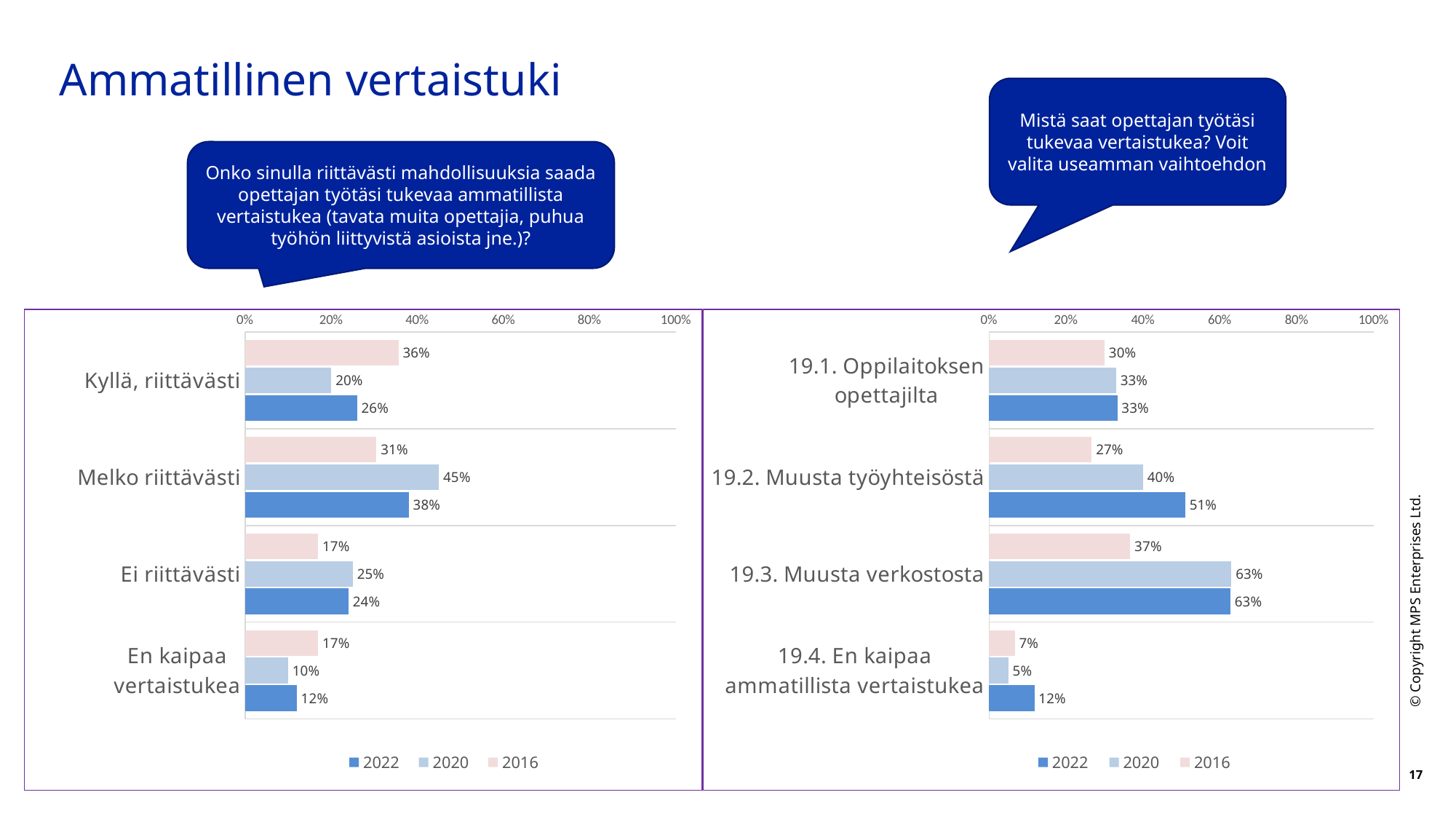
In the right chart, what is the 2016 value for "19.4. En kaipaa ammatillista vertaistukea"? 7% In the right chart, which category has the highest 2022 value? 19.3. Muusta verkostosta In the left chart, what is the difference between the 2020 and 2016 values for "Kyllä, riittävästi"? 16% In the left chart, what is the 2022 value for "Melko riittävästi"? 38% In the right chart, how many categories are shown? 4 In the left chart, which category has the lowest 2020 value? En kaipaa vertaistukea In the right chart, what is the 2022 value for "19.2. Muusta työyhteisöstä"? 51% In the left chart, how many series does the legend list? 3 What kind of chart is the right chart? bar chart In the right chart, is the 2022 value for "19.1. Oppilaitoksen opettajilta" larger or smaller than the 2022 value for "19.2. Muusta työyhteisöstä"? smaller In the left chart, which category has the highest 2020 value? Melko riittävästi In the left chart, what is the 2016 value for "Kyllä, riittävästi"? 36%